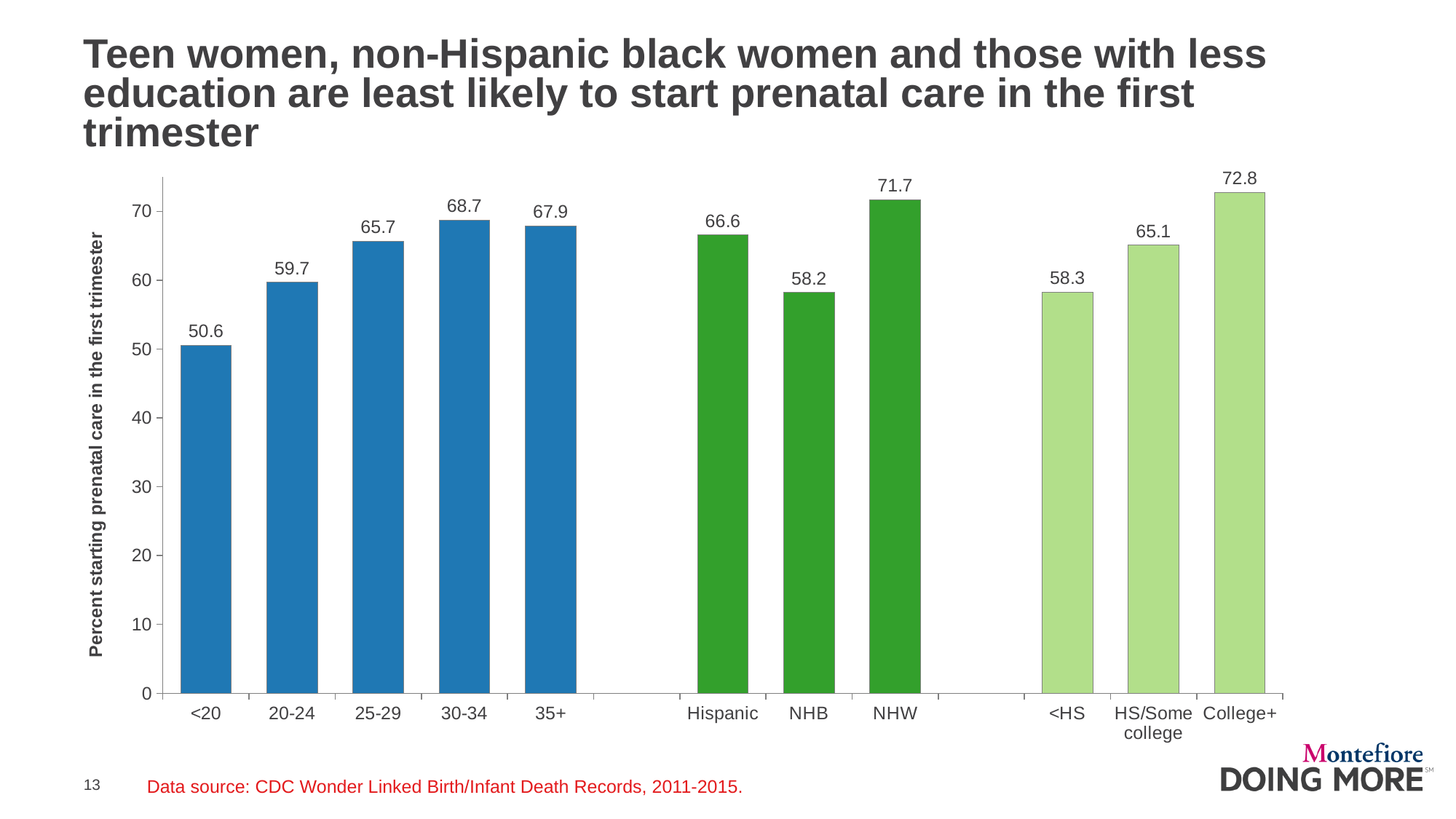
What is the value for the <20 age group? 50.6 What is the label of the vertical axis? Percent starting prenatal care in the first trimester What is the value for NHB? 58.2 Which is larger, the value for 30-34 or the value for 35+? 30-34 What is the value for College+? 72.8 Is the value for Hispanic greater or less than 60? greater What kind of chart is shown on the slide? bar chart What is the difference between the values for NHW and NHB? 13.5 Which category has the lowest value on the chart? <20 Which category has the highest value on the chart? College+ How many bars are plotted on the chart? 11 What is the difference between the values for College+ and <HS? 14.5